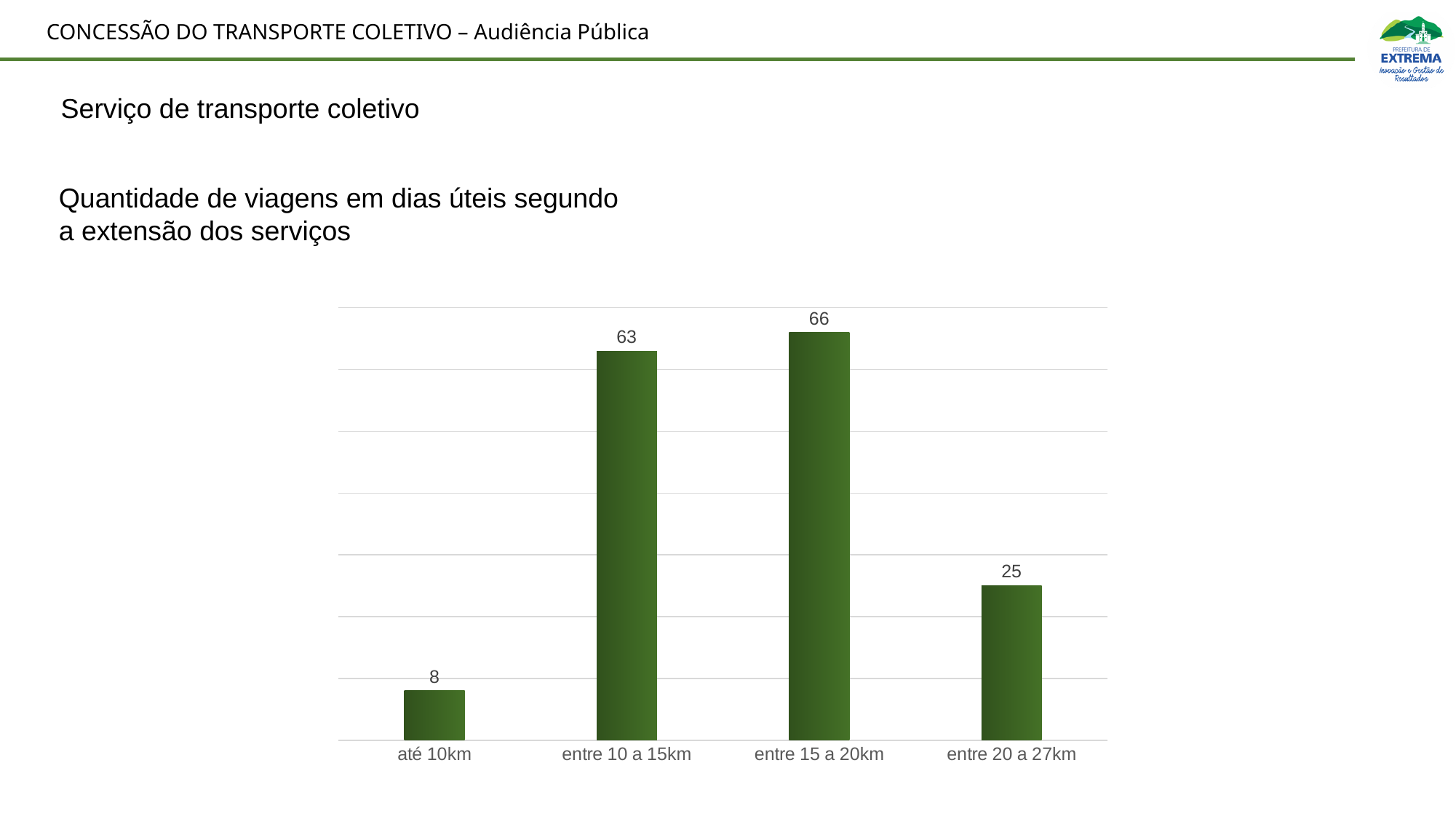
What is the number of trips for the 'entre 10 a 15km' category? 63 Which is larger, the value for 'entre 20 a 27km' or the value for 'até 10km'? entre 20 a 27km Which category has the highest number of trips? entre 15 a 20km What is the number of trips for the 'entre 20 a 27km' category? 25 Which category has the lowest number of trips? até 10km What is the number of trips for the 'até 10km' category? 8 What is the number of trips for the 'entre 15 a 20km' category? 66 What colour are the bars in the chart? green How many categories are shown on the x axis of the chart? 4 What is the difference between the values for 'entre 20 a 27km' and 'até 10km'? 17 What is the difference between the values for 'entre 15 a 20km' and 'entre 10 a 15km'? 3 What kind of chart is shown on the slide? bar chart